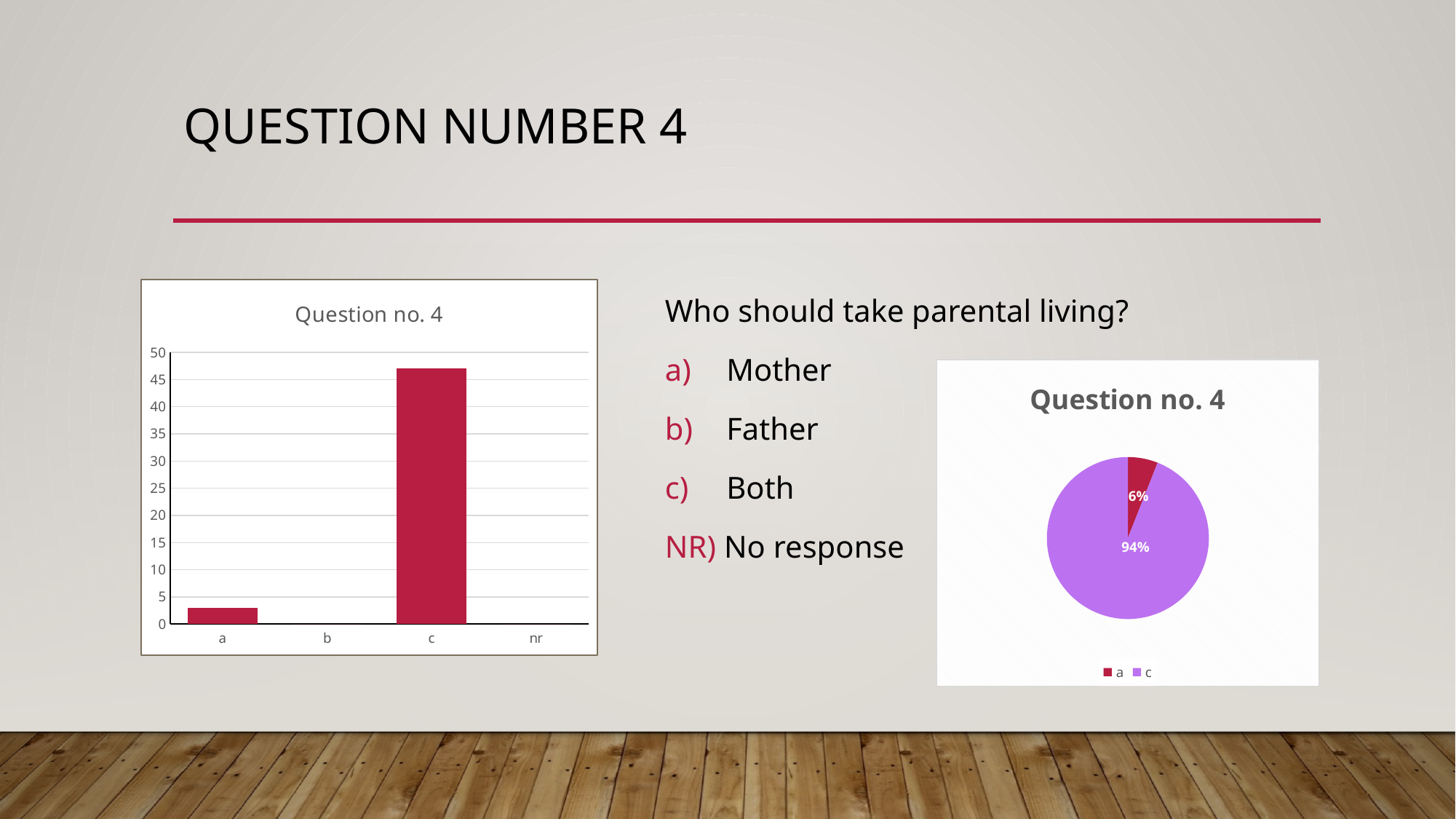
In the pie chart on the right, which slice is larger, a or c? c In the bar chart on the left, how many categories are shown on the x axis? 4 What kind of chart is the chart on the left of the slide? bar chart In the pie chart on the right, what is the difference in percentage points between slice c and slice a? 88 In the bar chart on the left, is the value for c greater or less than 40? greater In the bar chart on the left, which category has the highest bar? c In the pie chart on the right, how many entries does the legend list? 2 In the pie chart on the right, what share does slice a have? 6% What kind of chart is the chart on the right of the slide? pie chart In the bar chart on the left, is the value for a greater or less than 5? less In the pie chart on the right, what share does slice c have? 94% In the bar chart on the left, which is larger, the value for a or the value for c? c